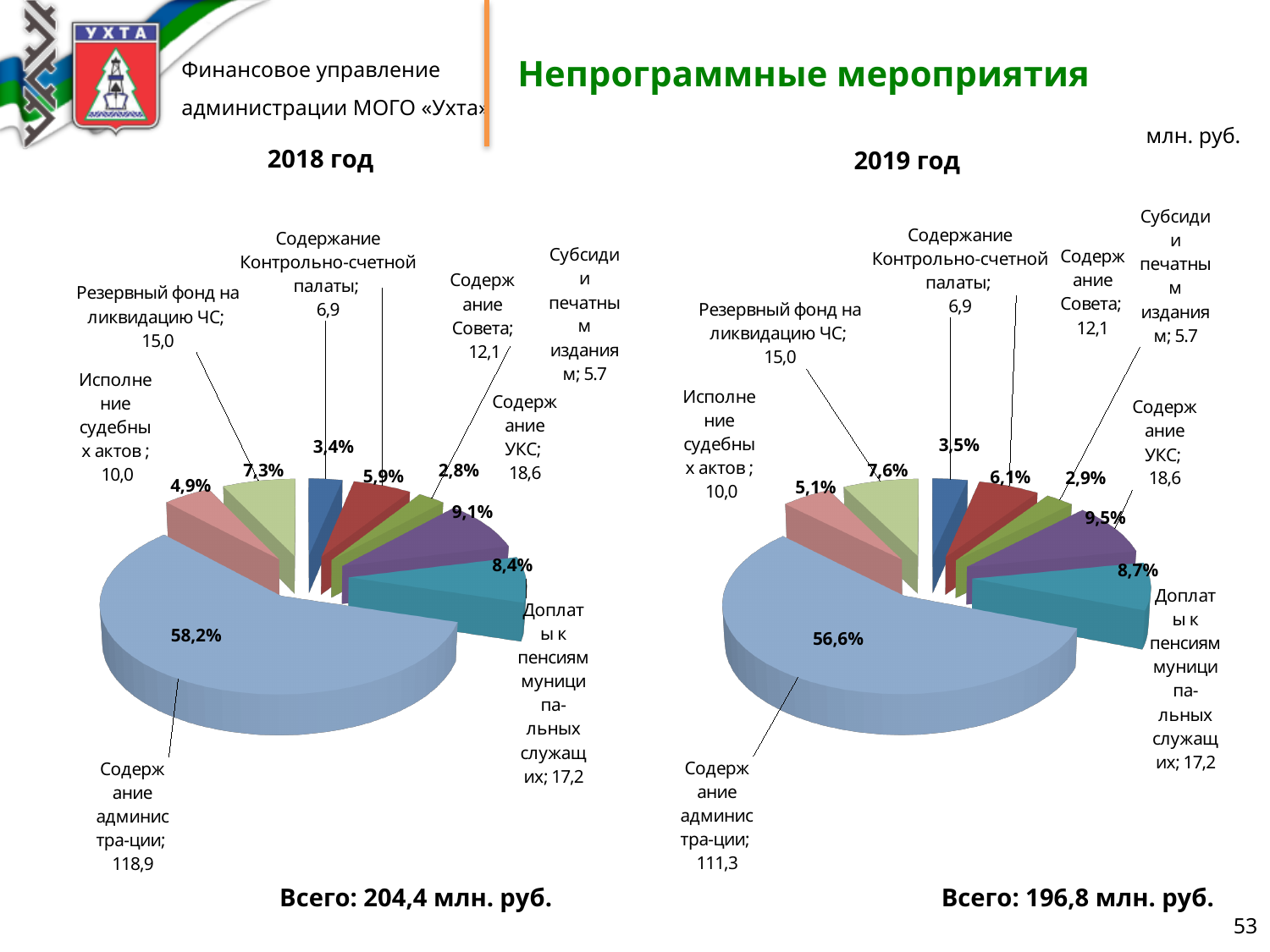
On the 2019 год chart, which category has the largest slice? Содержание администрации On the 2018 год chart, what is the value for Содержание администрации? 118,9 On the 2018 год chart, which category has the smallest slice? Субсидии печатным изданиям What kind of chart is used for 2018 год? Pie chart What is the total shown under the 2019 год chart? 196,8 млн. руб. How many slices does the 2019 год chart have? 8 On the 2018 год chart, what share of the pie is Содержание УКС? 9,1% On the 2018 год chart, which is larger: Резервный фонд на ликвидацию ЧС or Исполнение судебных актов? Резервный фонд на ликвидацию ЧС On the 2019 год chart, what is the value for Содержание администрации? 111,3 On the 2019 год chart, what is the value for Содержание Совета? 12,1 On the 2019 год chart, what share of the pie is Доплаты к пенсиям муниципальных служащих? 8,7% What is the difference between the value for Содержание администрации on the 2018 год chart and on the 2019 год chart? 7,6